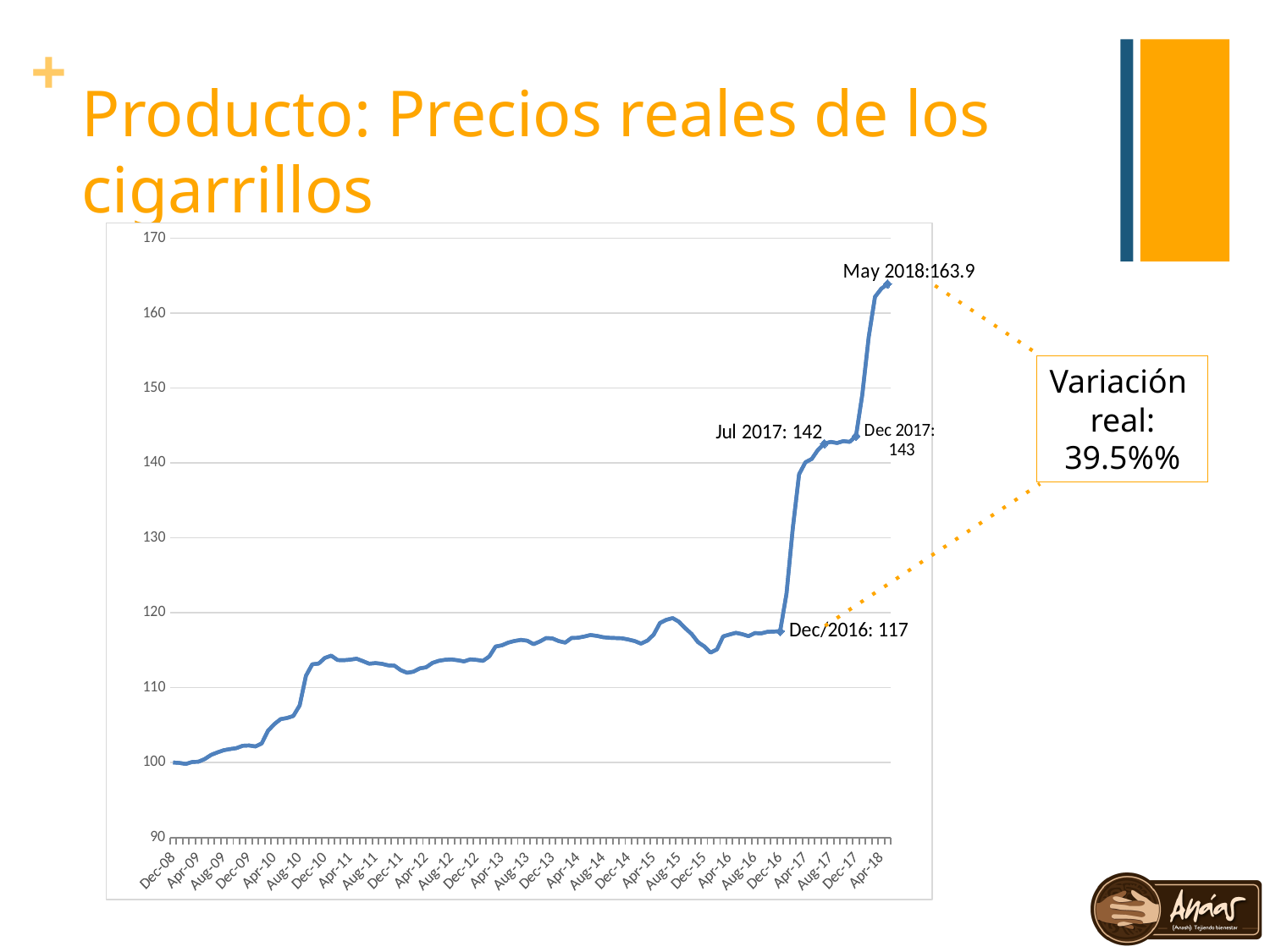
Which is larger, the value for Dec 2017 or the value for Jul 2017? Dec 2017 Do the values generally rise or fall from Dec-08 to Apr-18? rise What is the value labelled for May 2018? 163.9 What is the difference between the May 2018 value and the Dec 2016 value? 46.9 What is the value labelled for Dec 2016? 117 What is the difference between the Jul 2017 value and the Dec 2016 value? 25 Which of the labelled points has the highest value? May 2018 What is the value labelled for Dec 2017? 143 Is the value for Dec-08 greater or less than 110? less What real variation (Variación real) is stated in the text box next to the chart? 39.5%% What is the value labelled for Jul 2017? 142 What kind of chart is shown on the slide? line chart